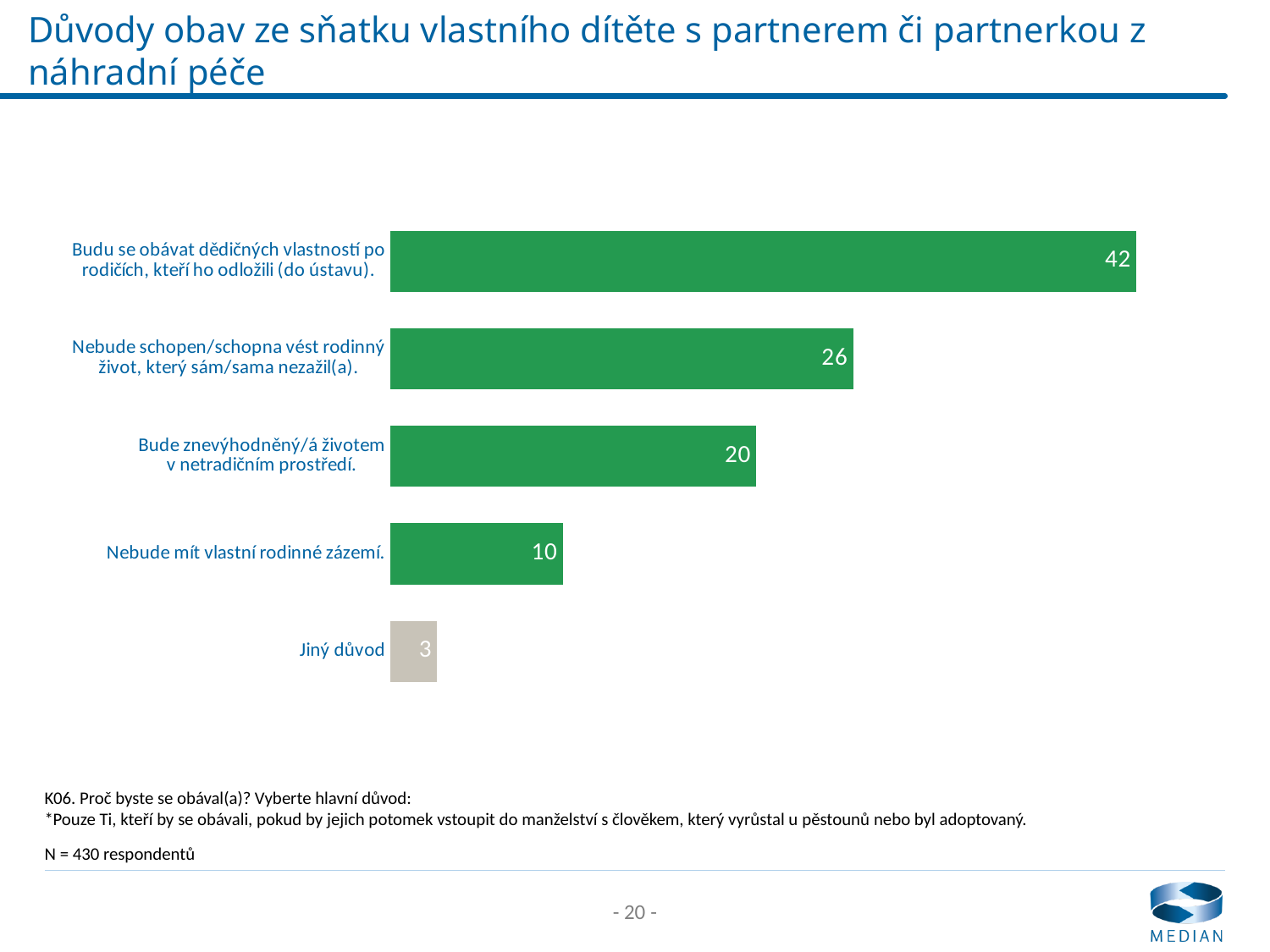
Which bar is shown in a different colour (grey) from the others? Jiný důvod What is the value for "Jiný důvod"? 3 Which is larger: the value for "Bude znevýhodněný/á životem v netradičním prostředí." or the value for "Nebude mít vlastní rodinné zázemí."? Bude znevýhodněný/á životem v netradičním prostředí. Which category has the highest value? Budu se obávat dědičných vlastností po rodičích, kteří ho odložili (do ústavu). What kind of chart is shown on the slide? Bar chart Which category has the lowest value? Jiný důvod How many categories are shown in the chart? 5 What is the value for "Nebude schopen/schopna vést rodinný život, který sám/sama nezažil(a)."? 26 What is the difference between the values for "Budu se obávat dědičných vlastností po rodičích, kteří ho odložili (do ústavu)." and "Nebude schopen/schopna vést rodinný život, který sám/sama nezažil(a)."? 16 What is the difference between the values for "Bude znevýhodněný/á životem v netradičním prostředí." and "Nebude mít vlastní rodinné zázemí."? 10 What is the value for "Nebude mít vlastní rodinné zázemí."? 10 What is the value for "Bude znevýhodněný/á životem v netradičním prostředí."? 20